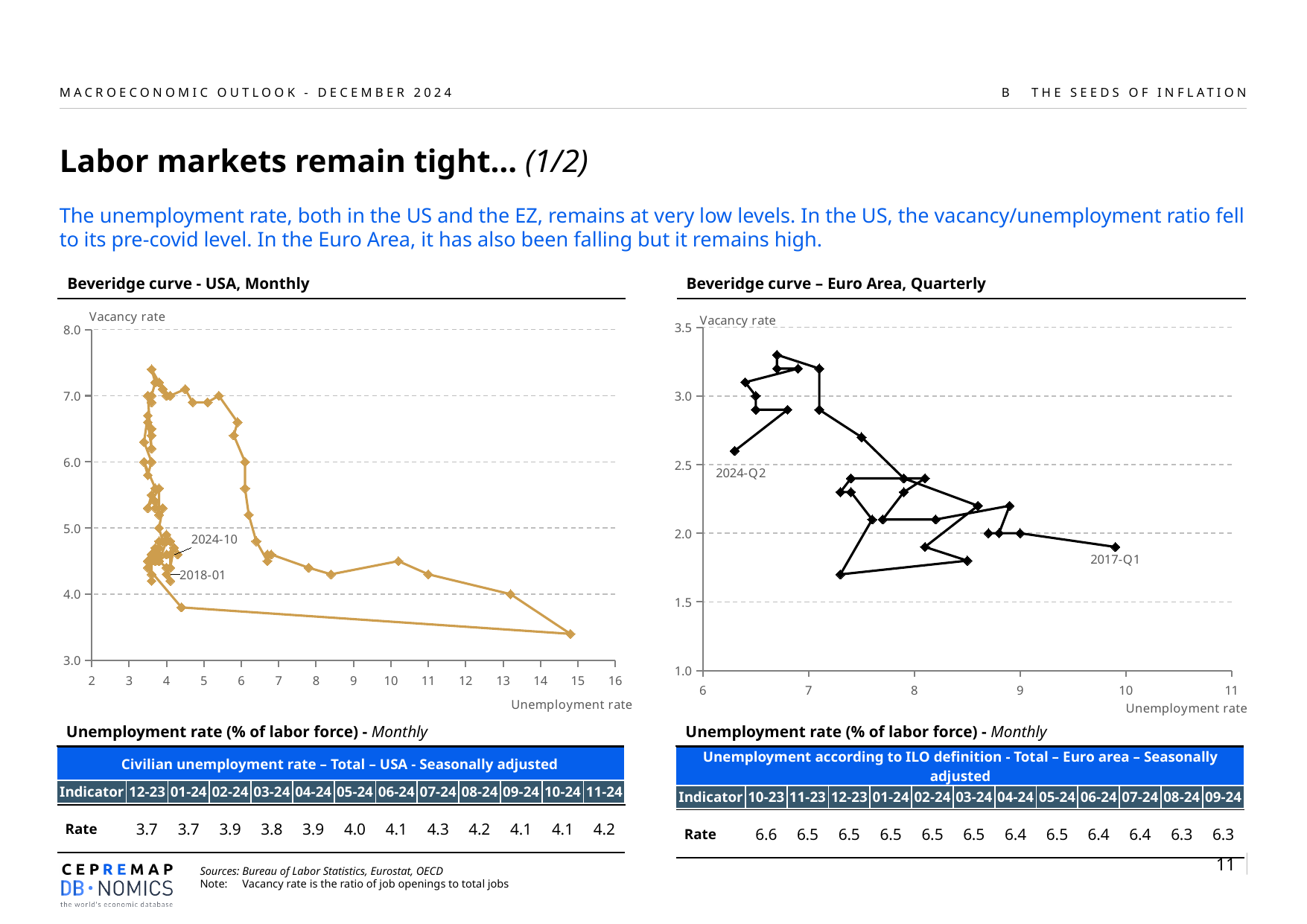
On the 'Beveridge curve - USA, Monthly' chart, is the highest vacancy rate reached greater or less than 7.0? greater On the 'Beveridge curve - USA, Monthly' chart, what variable is plotted on the horizontal axis? Unemployment rate On the 'Beveridge curve – Euro Area, Quarterly' chart, what variable is plotted on the vertical axis? Vacancy rate What kind of chart is the 'Beveridge curve - USA, Monthly' chart? line chart On the 'Beveridge curve - USA, Monthly' chart, is the unemployment rate for the rightmost point greater or less than 14? greater On the 'Beveridge curve - USA, Monthly' chart, is the vacancy rate for the point labelled 2024-10 greater or less than 5.0? less